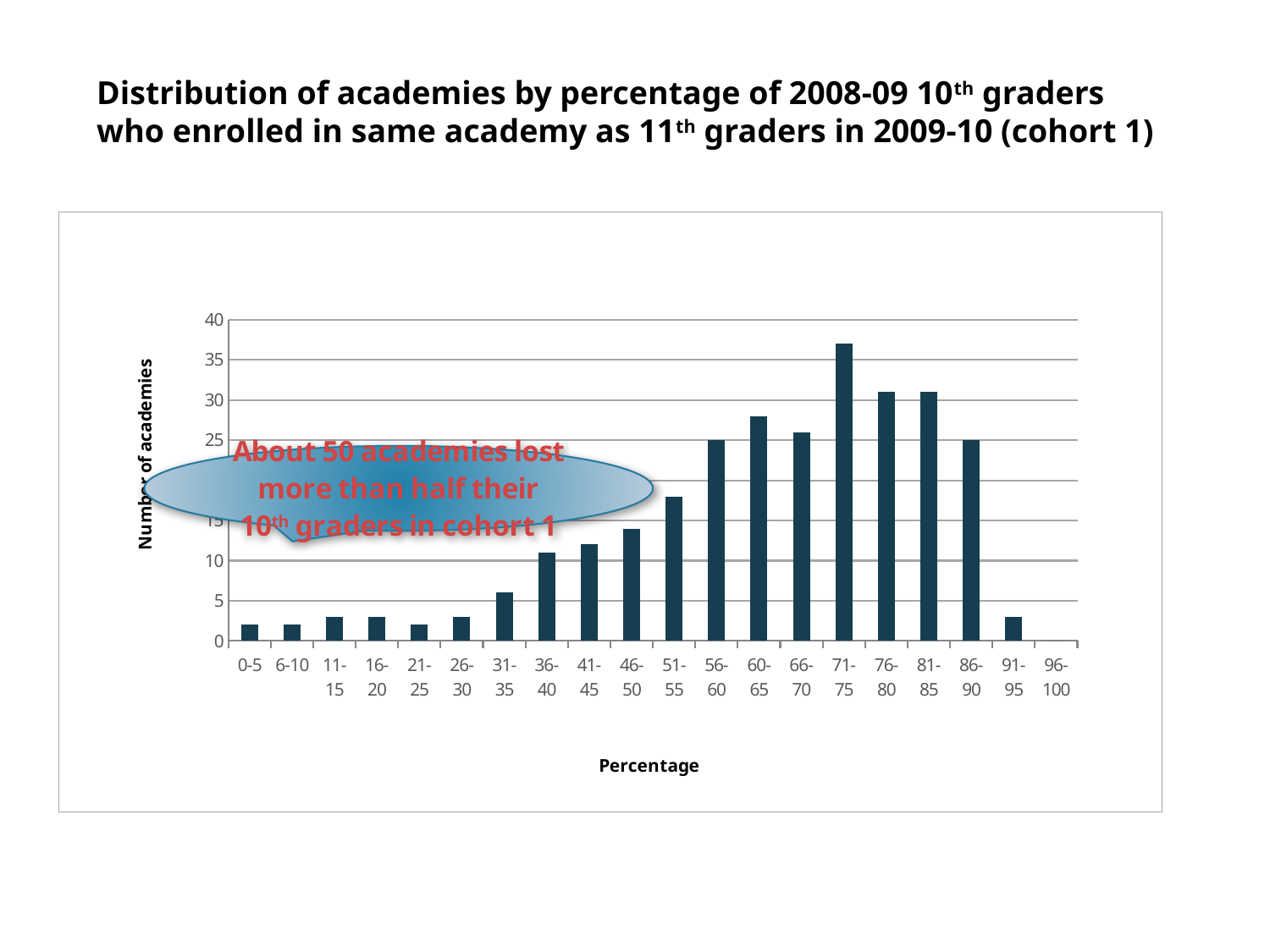
How many percentage ranges are shown on the x axis? 20 Is the number of academies for the 71-75 range greater or less than 35? greater Is the number of academies for the 36-40 range greater or less than 10? greater Which percentage range has the highest number of academies? 71-75 What is the label of the horizontal axis? Percentage Which range has more academies, 71-75 or 76-80? 71-75 What is the label of the vertical axis? Number of academies What kind of chart is shown on the slide? bar chart Is the number of academies for the 0-5 range greater or less than 5? less Which range has more academies, 31-35 or 36-40? 36-40 Which percentage range has the lowest number of academies? 96-100